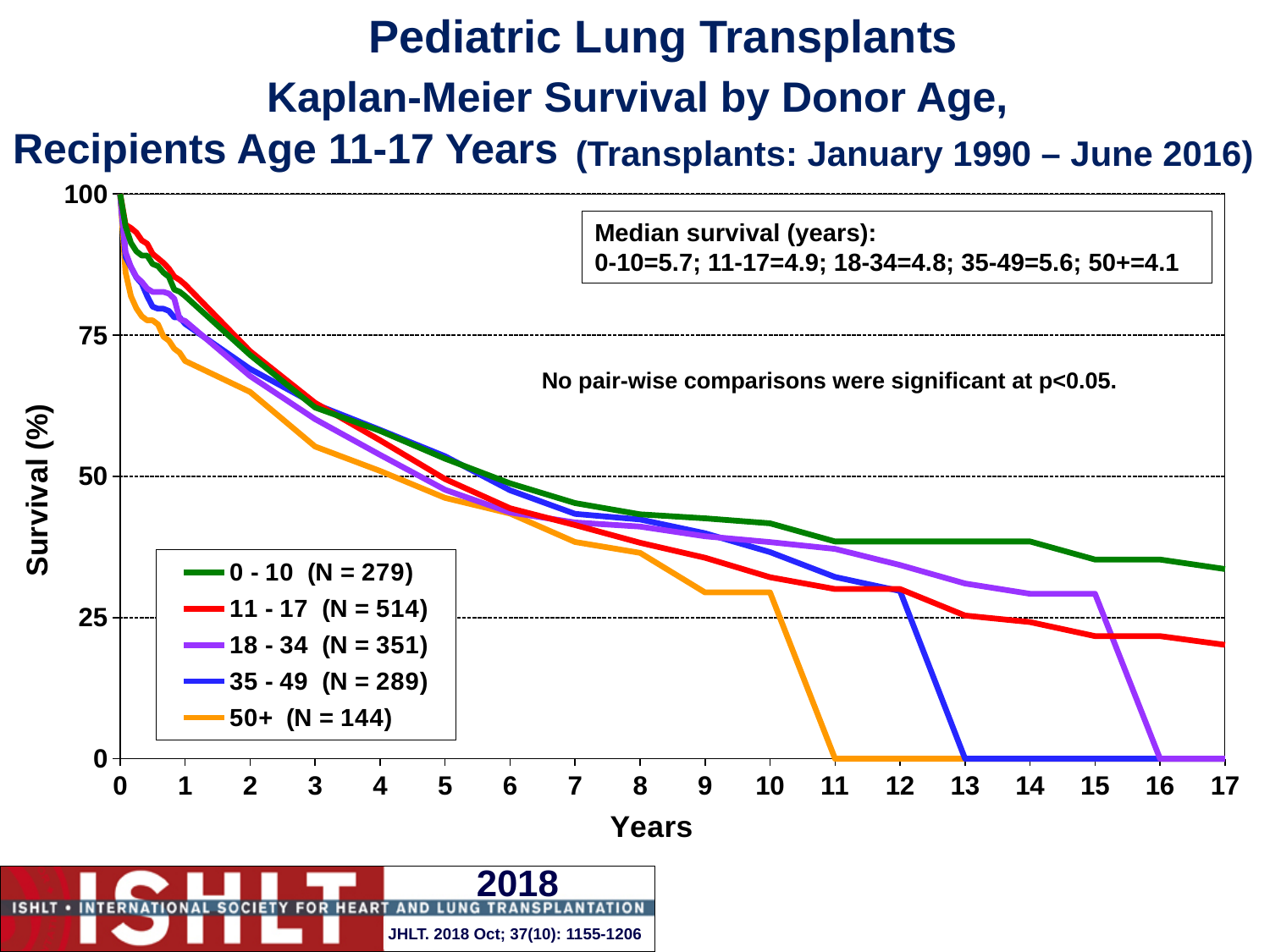
What kind of chart is shown on the slide? line chart Which donor age group has the highest median survival? 0 - 10 What is the N for the 18-34 donor age group in the legend? 351 Which donor age group has the larger N, 11-17 or 35-49? 11 - 17 At 10 years, is the survival for the 50+ donor age group greater or less than 50? less At 14 years, is the survival for the 0-10 donor age group greater or less than 25? greater How many donor age groups (series) does the legend list? 5 What is the median survival in years for the 0-10 donor age group? 5.7 What is the difference in median survival (years) between the 0-10 and 50+ donor age groups? 1.6 Do the survival curves rise or fall as years increase along the x axis? fall What is the label of the x axis? Years Which donor age group has the lowest median survival? 50+